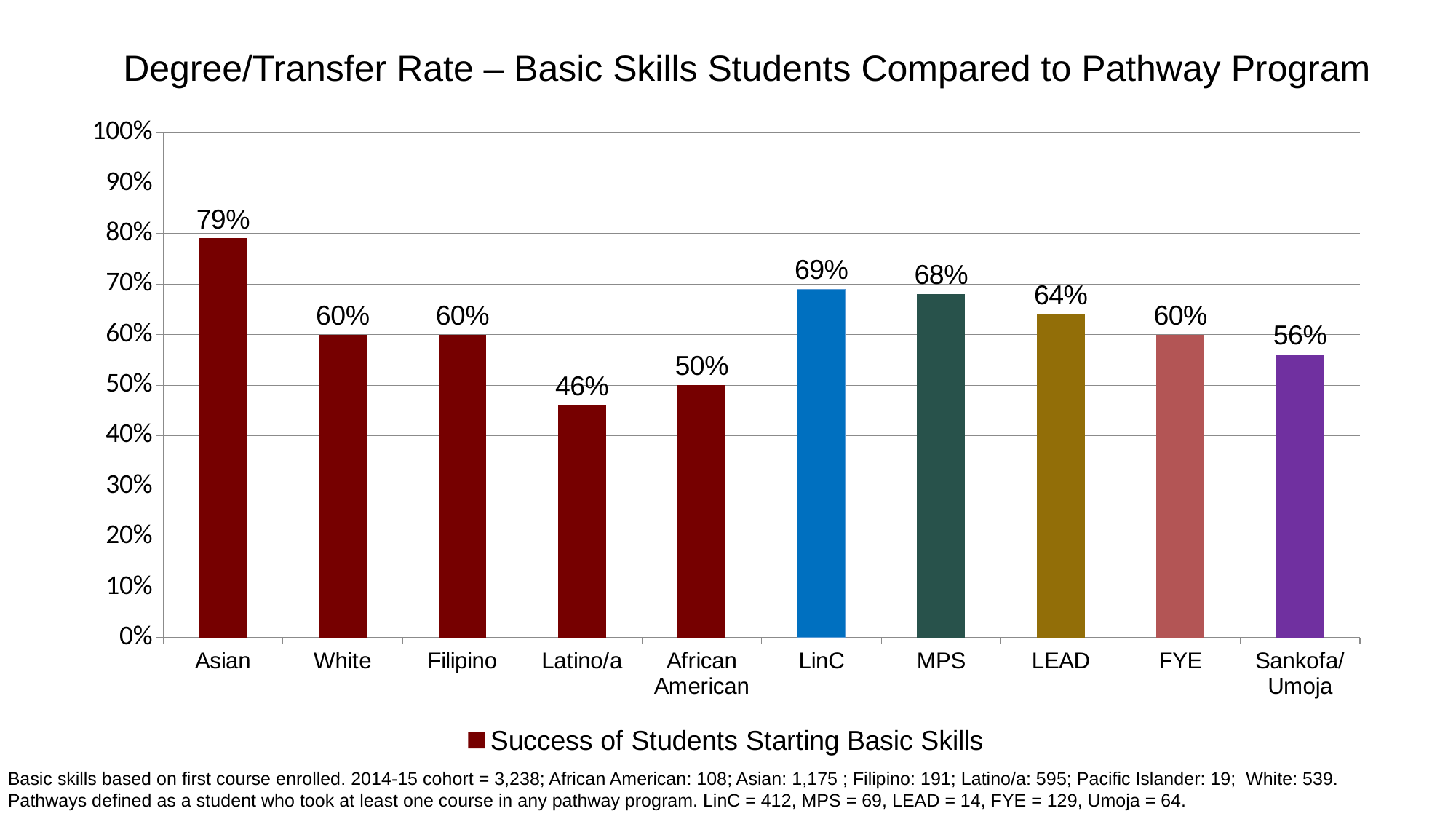
Which category has the lowest value? Latino/a What is the difference between the values for Asian and Latino/a? 33% What is the degree/transfer rate for Asian students? 79% Which category has the highest value? Asian Is the value for African American greater or less than 60%? less What is the value shown for Sankofa/Umoja? 56% What is the legend entry shown below the chart? Success of Students Starting Basic Skills Which is larger, the value for MPS or the value for LEAD? MPS What kind of chart is this? bar chart How many categories are shown on the x axis? 10 What is the difference between the values for LinC and African American? 19% What is the value shown for LinC? 69%